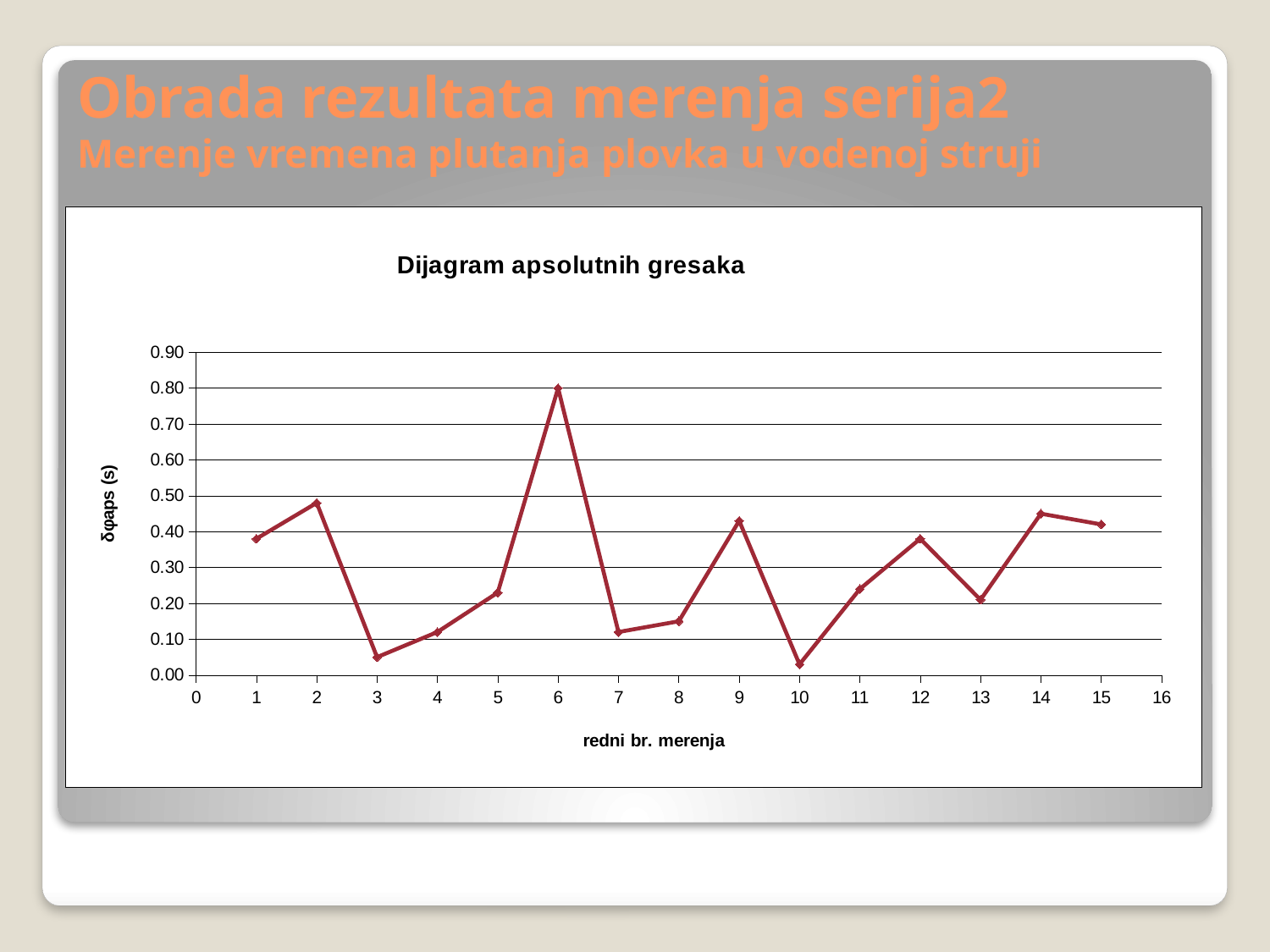
What is the label of the x axis? redni br. merenja What is the value for measurement 6? 0.80 Is the value for measurement 14 greater or less than 0.40? greater Is the value for measurement 10 greater or less than 0.10? less Is the value for measurement 1 greater or less than 0.30? greater What kind of chart is shown on the slide? line chart Which measurement number has the highest absolute error? 6 How many measurement points are plotted on the chart? 15 Which has the larger value, measurement 2 or measurement 3? measurement 2 What is the title of the chart? Dijagram apsolutnih gresaka Which measurement number has the lowest absolute error? 10